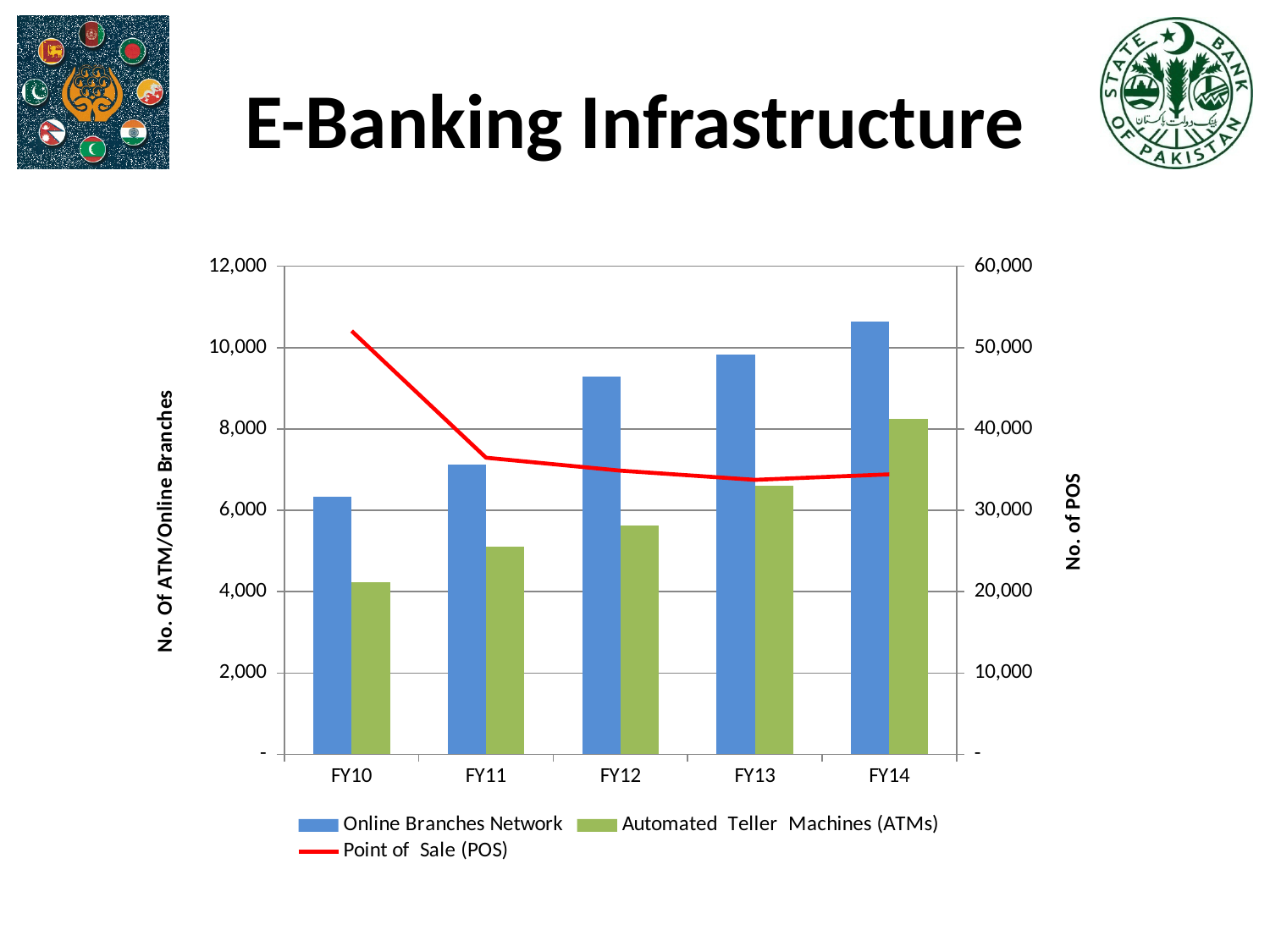
What kind of chart is shown on the slide? A combination bar and line chart Do the Online Branches Network values rise or fall from FY10 to FY14? Rise In which fiscal year is the Online Branches Network highest? FY14 How many fiscal years are shown on the x axis? 5 Is the Online Branches Network value for FY14 greater or less than 10,000? greater In which fiscal year is the Point of Sale (POS) value highest? FY10 Is the Automated Teller Machines (ATMs) value for FY10 greater or less than 5,000? less What is the title of the right-hand vertical axis? No. of POS How many series does the legend list? 3 Does the Point of Sale (POS) line rise or fall from FY10 to FY14? Fall In which fiscal year is the number of Automated Teller Machines (ATMs) lowest? FY10 Is the Point of Sale (POS) value for FY10 greater or less than 50,000? greater